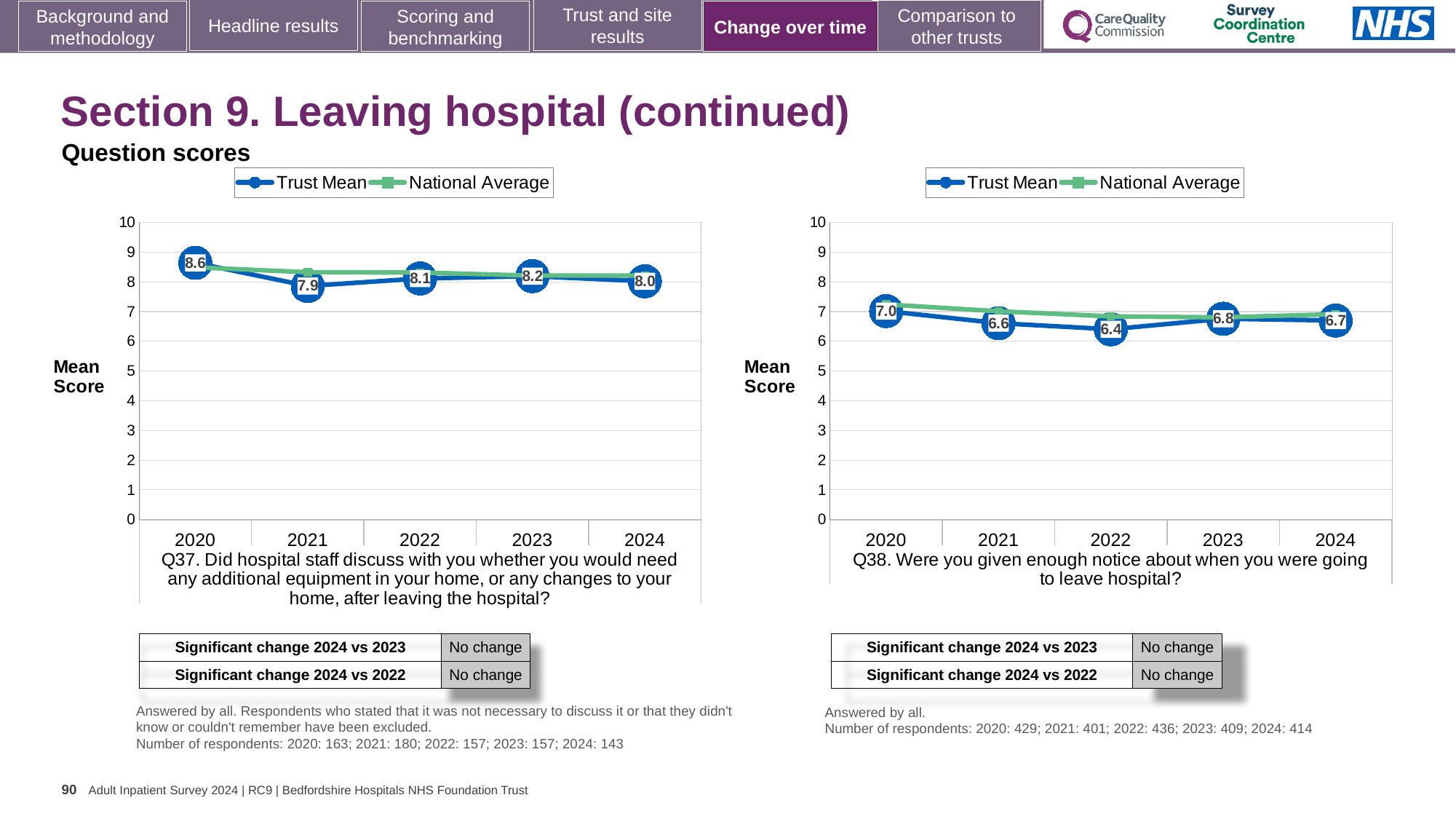
In the Q37 chart on the left, which year has the highest Trust Mean score? 2020 In the Q37 chart on the left, what is the Trust Mean score for 2020? 8.6 In the Q37 chart on the left, which year has the lowest Trust Mean score? 2021 In the Q38 chart on the right, is the Trust Mean score for 2020 higher or lower than the score for 2024? higher What type of chart is the Q38 chart on the right? line chart In the Q37 chart on the left, what is the difference between the Trust Mean scores for 2020 and 2021? 0.7 In the Q38 chart on the right, which year has the lowest Trust Mean score? 2022 How many series does the legend of the Q37 chart on the left list? 2 In the Q38 chart on the right, what is the Trust Mean score for 2023? 6.8 In the Q38 chart on the right, is the National Average for 2020 greater or less than 8? less In the Q37 chart on the left, what is the Trust Mean score for 2024? 8.0 In the Q38 chart on the right, what is the Trust Mean score for 2022? 6.4